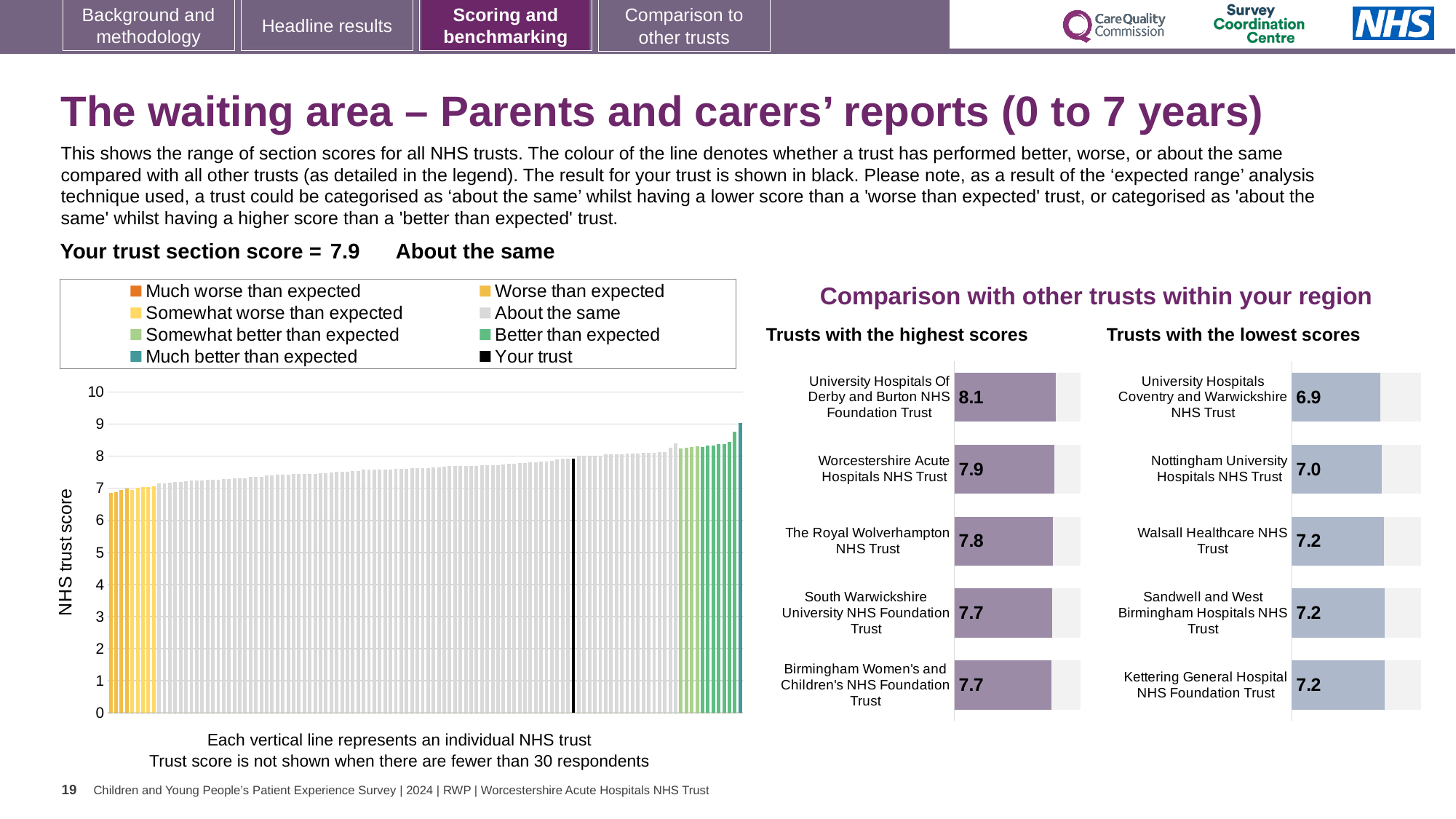
How many trusts are listed in the 'Trusts with the highest scores' chart? 5 In the 'Trusts with the lowest scores' chart, which trust has the lowest score? University Hospitals Coventry and Warwickshire NHS Trust In the 'Trusts with the highest scores' chart, which trust has the highest score? University Hospitals Of Derby and Burton NHS Foundation Trust In the large chart on the left showing all NHS trusts, do the scores rise or fall from left to right? rise In the 'Trusts with the lowest scores' chart, what is the score for Nottingham University Hospitals NHS Trust? 7.0 In the 'Trusts with the highest scores' chart, what is the difference between the scores of University Hospitals Of Derby and Burton NHS Foundation Trust and Worcestershire Acute Hospitals NHS Trust? 0.2 How many entries does the legend of the large chart on the left list? 8 In the 'Trusts with the highest scores' chart, what is the score for The Royal Wolverhampton NHS Trust? 7.8 In the 'Trusts with the lowest scores' chart, which has the larger score: Walsall Healthcare NHS Trust or Nottingham University Hospitals NHS Trust? Walsall Healthcare NHS Trust In the 'Trusts with the lowest scores' chart, what is the difference between the scores of Kettering General Hospital NHS Foundation Trust and University Hospitals Coventry and Warwickshire NHS Trust? 0.3 In the large chart on the left showing all NHS trusts, is the value of the tallest bar greater or less than 8? greater In the 'Trusts with the highest scores' chart, what is the score for University Hospitals Of Derby and Burton NHS Foundation Trust? 8.1